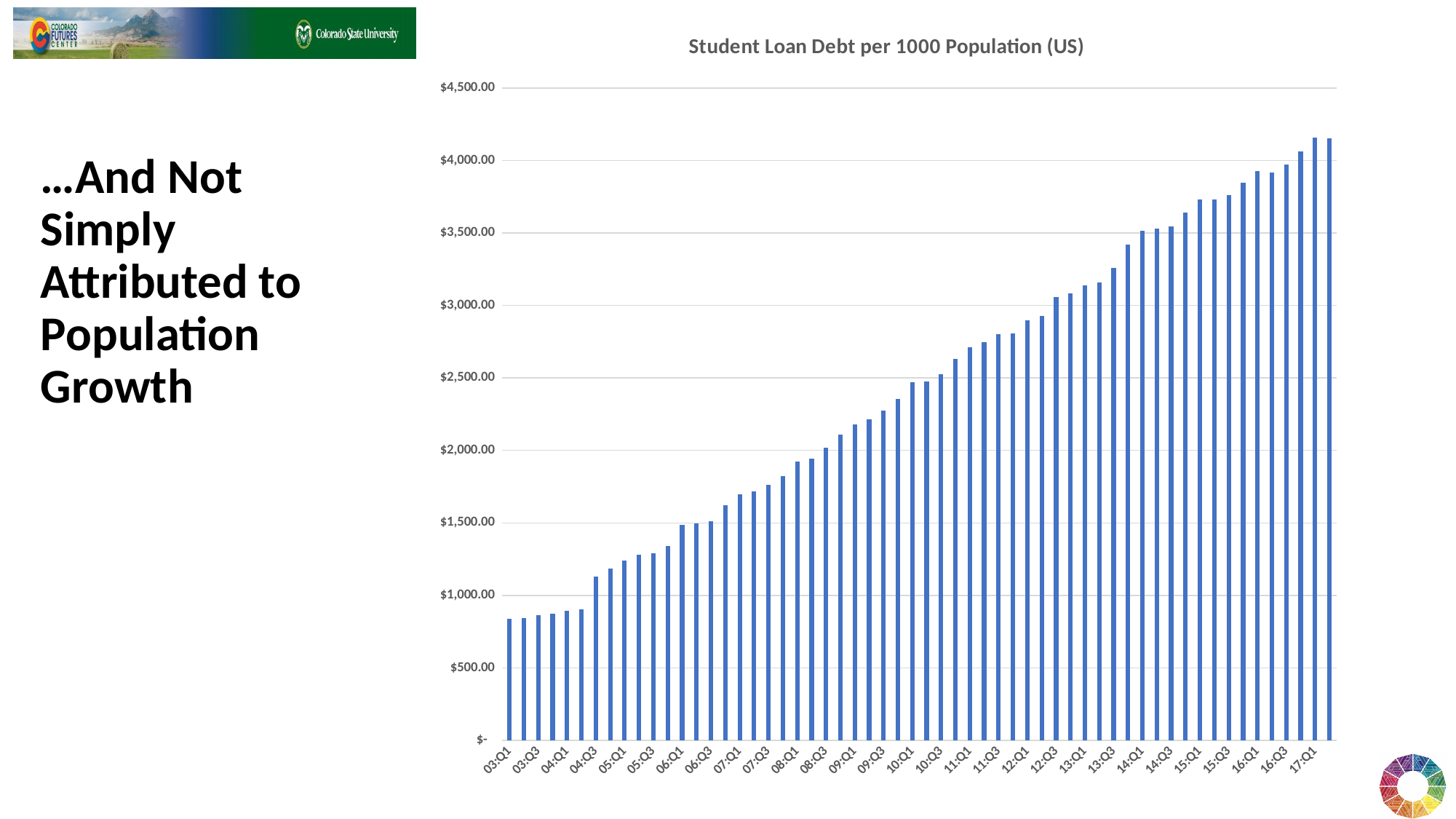
Is the value for 12:Q1 greater or less than $3,000.00? less Is the value for 11:Q1 greater or less than $2,500.00? greater Which quarter has the lowest value on the chart? 03:Q1 What is the title of the chart? Student Loan Debt per 1000 Population (US) Is the value for 03:Q1 greater or less than $1,000.00? less Which is larger, the value for 17:Q1 or the value for 03:Q1? 17:Q1 Do the values generally rise or fall from 03:Q1 to 17:Q1? Rise What kind of chart is shown on the slide? Bar chart